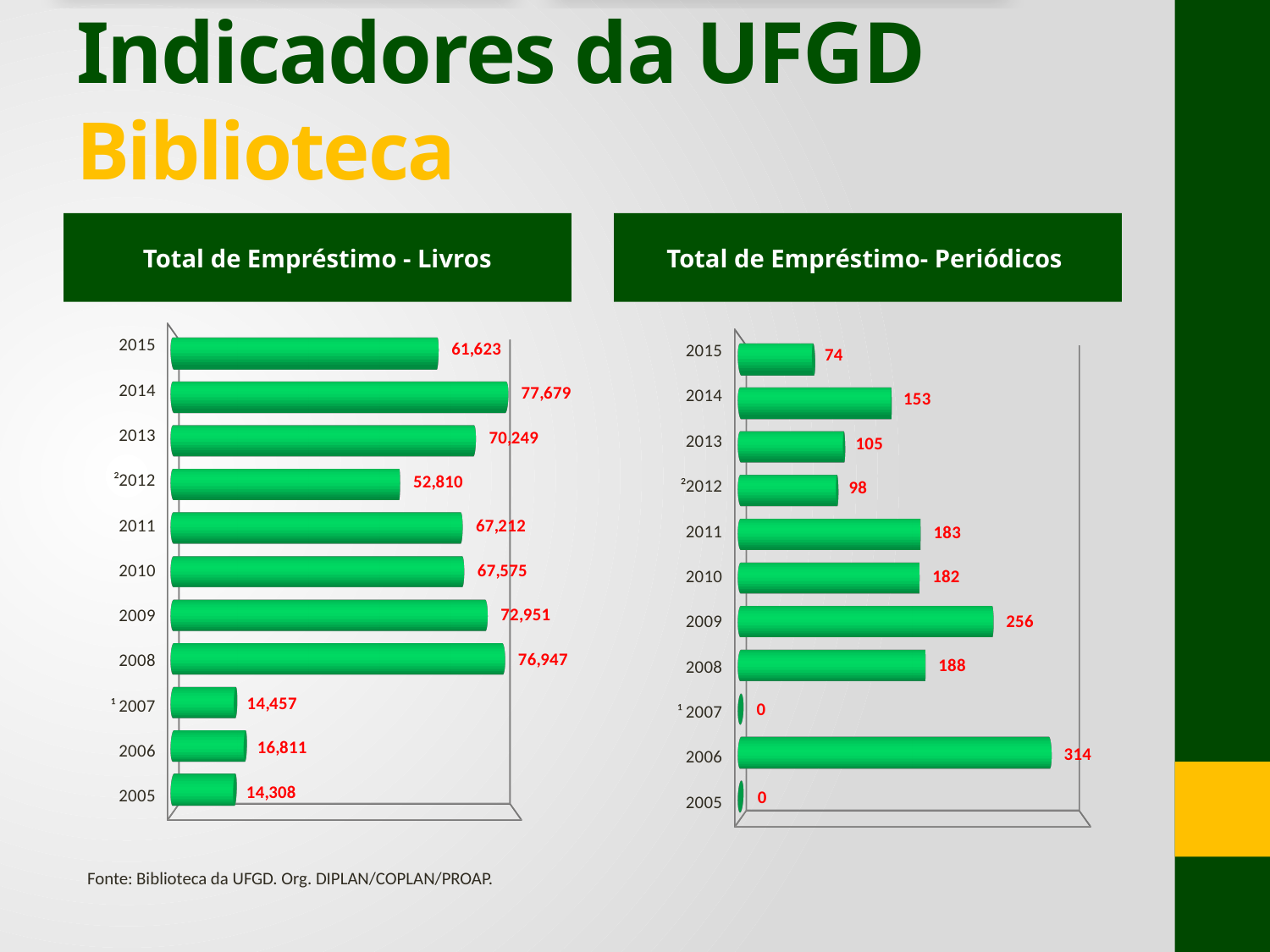
In the 'Total de Empréstimo - Livros' chart, what is the difference between the values for 2014 and 2015? 16,056 In the 'Total de Empréstimo- Periódicos' chart, which year has the highest value? 2006 In the 'Total de Empréstimo - Livros' chart, which year has the lowest value? 2005 How many years are shown in the 'Total de Empréstimo- Periódicos' chart? 11 What kind of chart is the 'Total de Empréstimo - Livros' chart? Bar chart In the 'Total de Empréstimo - Livros' chart, what is the value for 2014? 77,679 In the 'Total de Empréstimo- Periódicos' chart, what is the value for 2009? 256 In the 'Total de Empréstimo - Livros' chart, what is the value for 2012? 52,810 In the 'Total de Empréstimo - Livros' chart, which is larger, the value for 2008 or the value for 2009? 2008 In the 'Total de Empréstimo- Periódicos' chart, which is larger, the value for 2014 or the value for 2013? 2014 In the 'Total de Empréstimo- Periódicos' chart, what is the difference between the values for 2009 and 2008? 68 In the 'Total de Empréstimo - Livros' chart, which year has the highest value? 2014